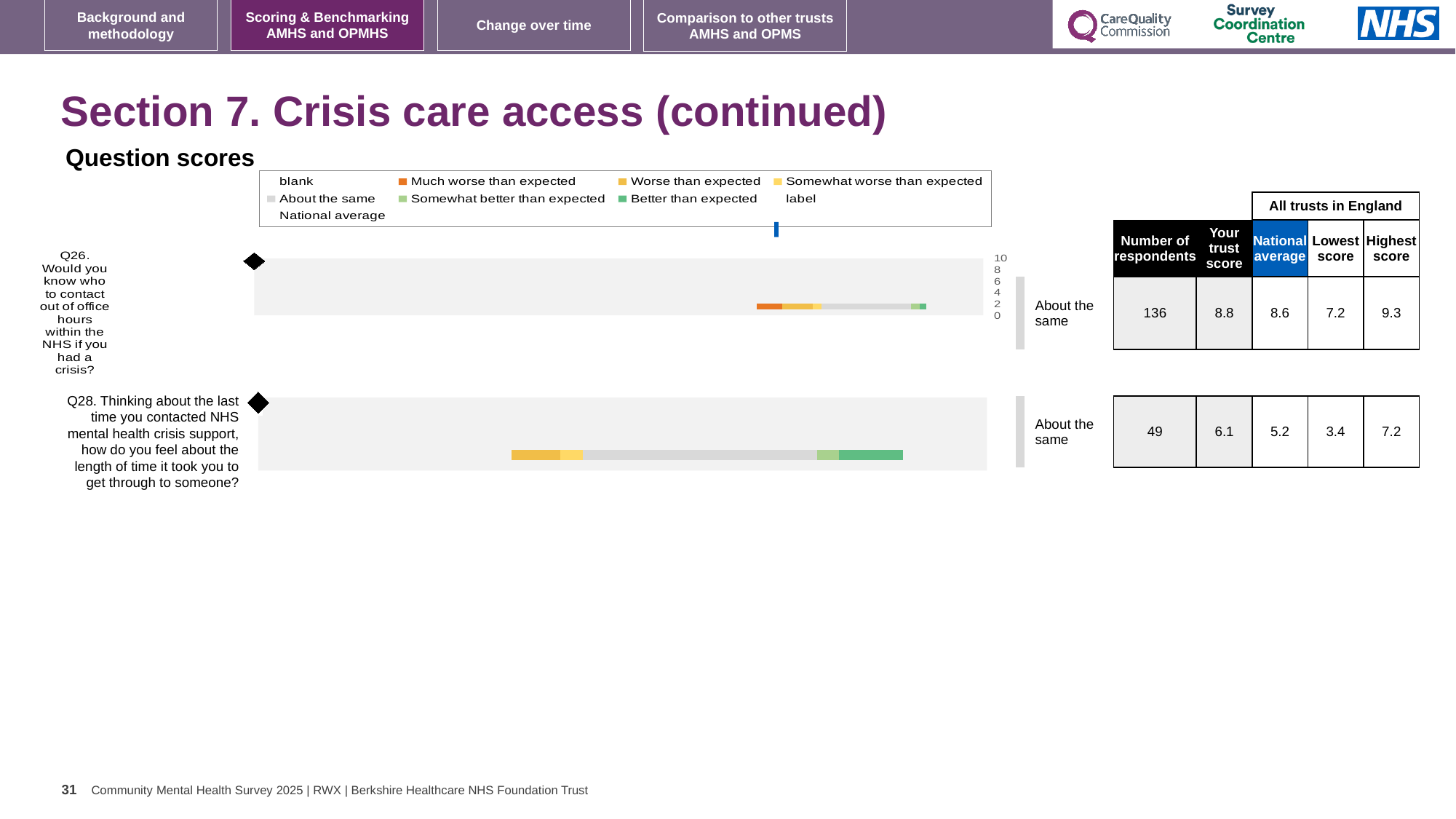
Which question has the higher trust score, Q26 or Q28? Q26 What benchmark category is shown next to the Q28 chart? About the same What is the trust score for Q26 (knowing who to contact out of office hours in a crisis)? 8.8 What is the national average score for Q26? 8.6 How many entries does the legend above the question scores charts list? 9 How many respondents answered Q28? 49 How many questions are plotted in the question scores charts? 2 What is the difference between the highest and lowest trust scores in England for Q26? 2.1 What is the maximum value shown on the score axis of the Q26 chart? 10 What kind of chart is used to show the question scores for Q26 and Q28? bar chart What is the trust score for Q28 (length of time to get through to crisis support)? 6.1 What is the lowest score among all trusts in England for Q28? 3.4